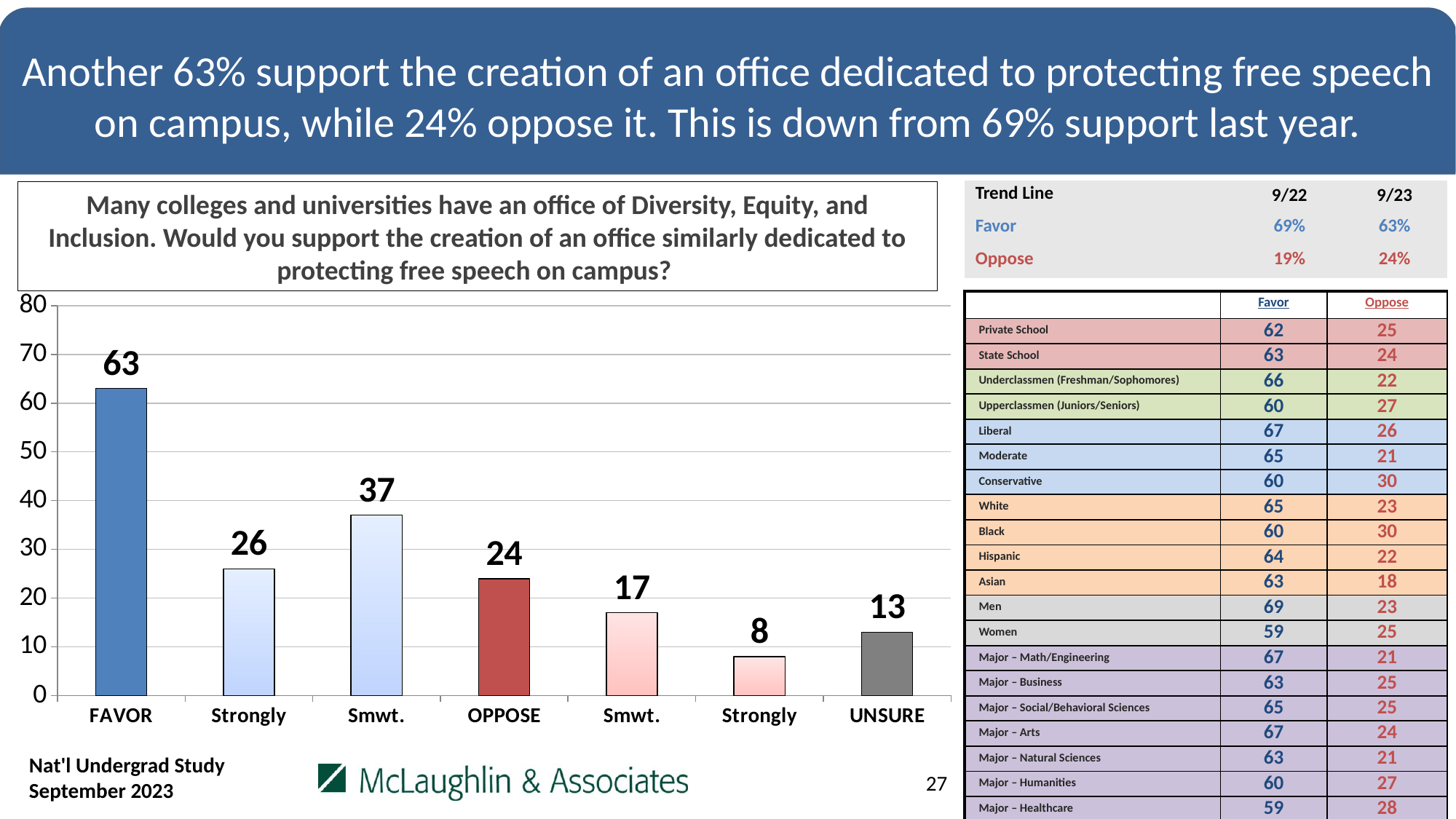
What is the maximum value shown on the vertical axis? 80 How many bars are in the chart? 7 What is the value of the second bar from the left (Strongly, next to FAVOR)? 26 What is the value of the UNSURE bar? 13 What type of chart is shown? Bar chart What is the value of the OPPOSE bar? 24 Which is larger, the Smwt. bar next to FAVOR or the Smwt. bar next to OPPOSE? The Smwt. bar next to FAVOR (37) What is the value of the FAVOR bar? 63 What is the value of the sixth bar from the left (Strongly, next to OPPOSE)? 8 What is the difference between the FAVOR bar and the OPPOSE bar? 39 Which category has the highest bar? FAVOR Which category has the lowest bar? Strongly (oppose), the sixth bar